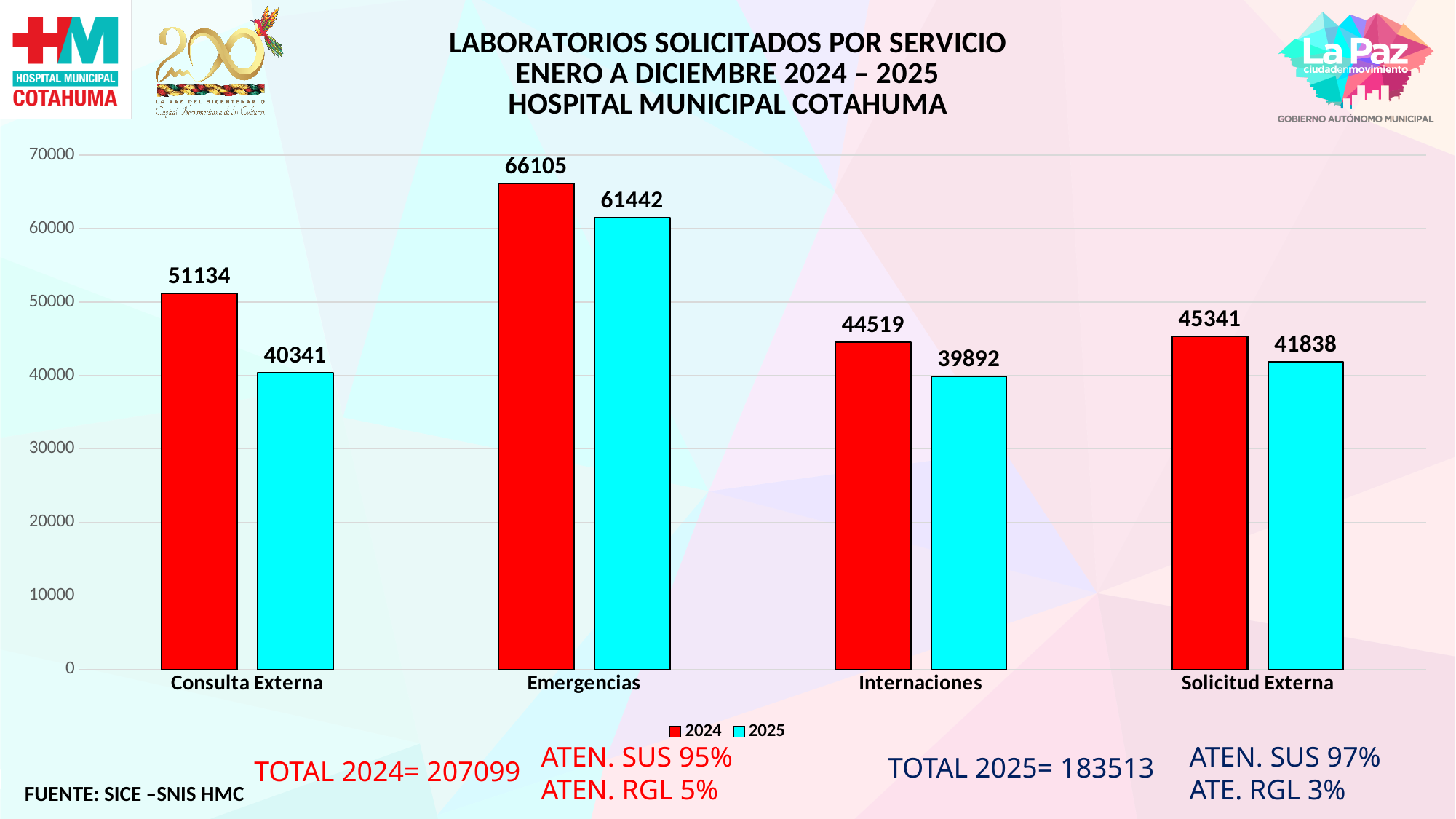
What is the value for Consulta Externa in the 2025 series? 40341 How many series does the legend list? 2 What is the difference between the 2024 and 2025 values for Consulta Externa? 10793 What is the value for Internaciones in the 2025 series? 39892 What is the value for Solicitud Externa in the 2024 series? 45341 Which is larger for Internaciones: the 2024 value or the 2025 value? 2024 What kind of chart is shown on the slide? bar chart How many categories are shown on the x axis? 4 Which category has the lowest value in the 2025 series? Internaciones What is the value for Emergencias in the 2024 series? 66105 Is the 2025 value for Emergencias greater or less than 60000? greater Which category has the highest value in the 2024 series? Emergencias